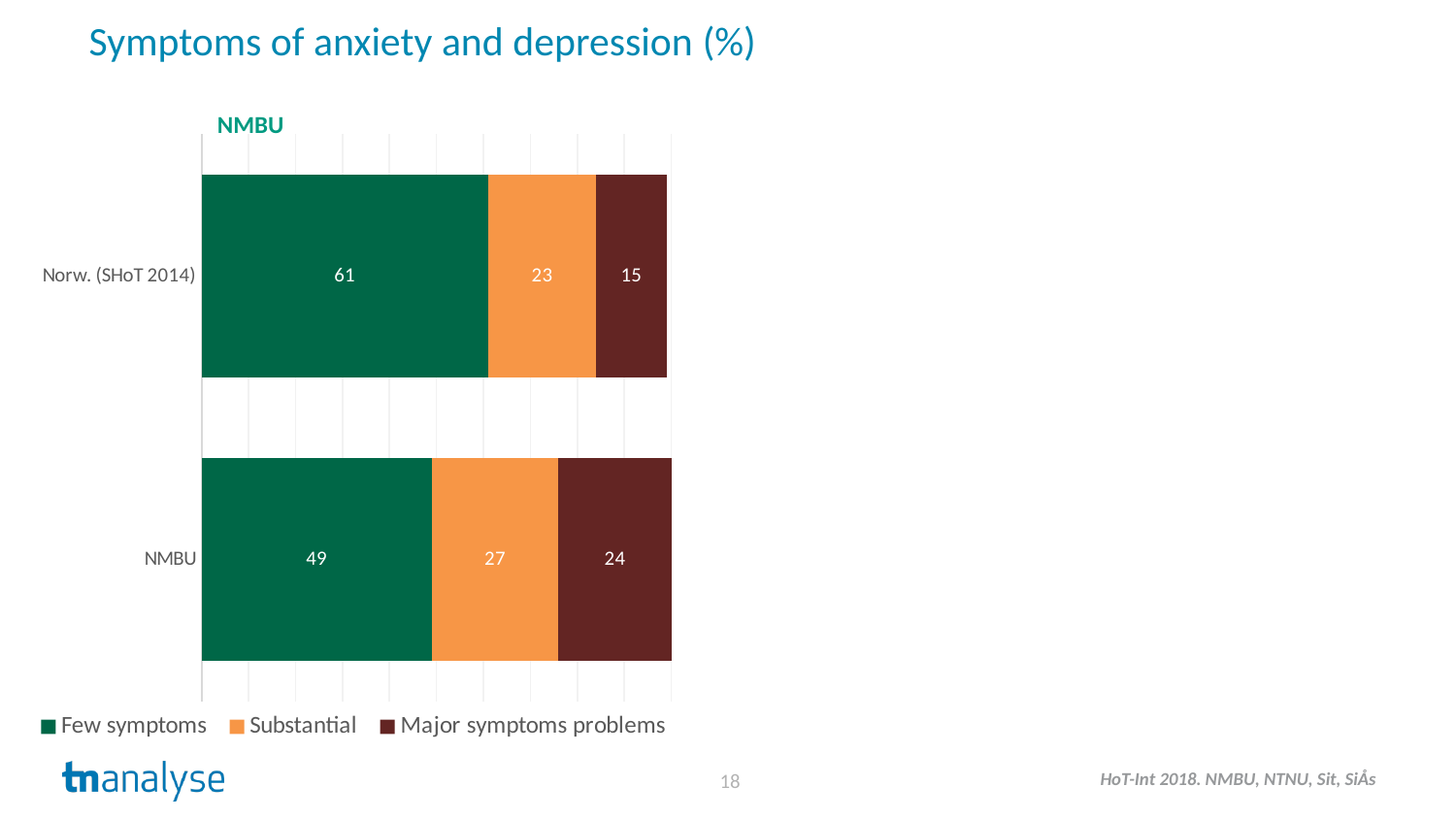
What is the value for Substantial in the NMBU bar? 27 Which category has the higher value for Few symptoms, Norw. (SHoT 2014) or NMBU? Norw. (SHoT 2014) What is the value for Substantial in the Norw. (SHoT 2014) bar? 23 Which category has the higher value for Major symptoms problems? NMBU How many series does the legend list? 3 What is the difference between the Major symptoms problems values for NMBU and Norw. (SHoT 2014)? 9 What is the difference between the Few symptoms values for Norw. (SHoT 2014) and NMBU? 12 What kind of chart is shown on the slide? Stacked bar chart What is the total of the stacked bar for NMBU? 100 What is the value for Few symptoms in the Norw. (SHoT 2014) bar? 61 What is the value for Major symptoms problems in the NMBU bar? 24 How many categories are shown on the chart? 2